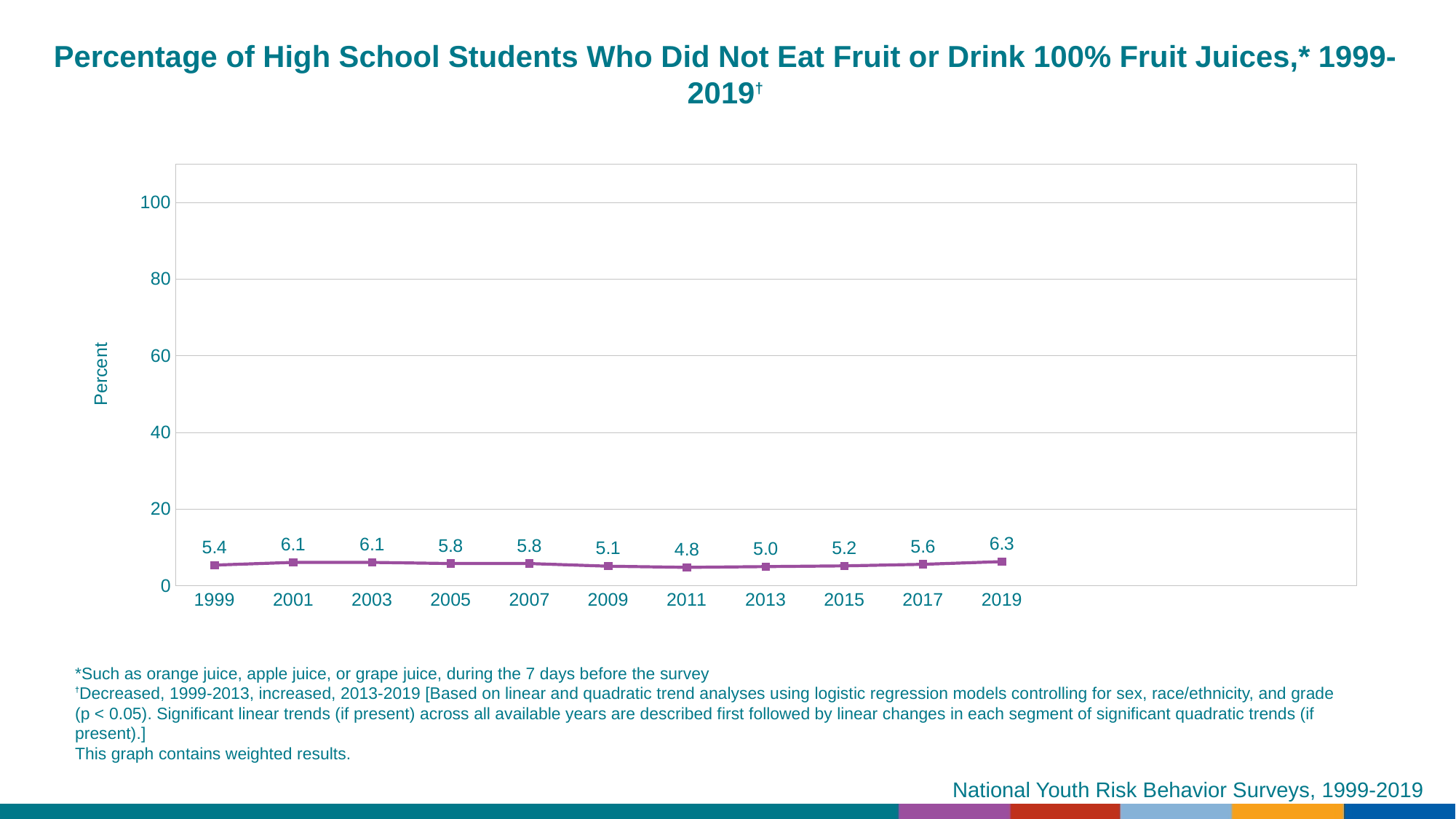
What is the value for 2019? 6.3 How many years are plotted on the x axis? 11 Which is larger, the value for 2001 or the value for 2009? 2001 Is the value for 2007 greater or less than 20? less What kind of chart is shown? line chart Which year has the lowest value? 2011 Which year has the highest value? 2019 What is the value for 1999? 5.4 Do the values rise or fall from 2013 to 2019? rise What is the difference between the values for 2019 and 2011? 1.5 What is the value for 2011? 4.8 What is the label on the y axis? Percent